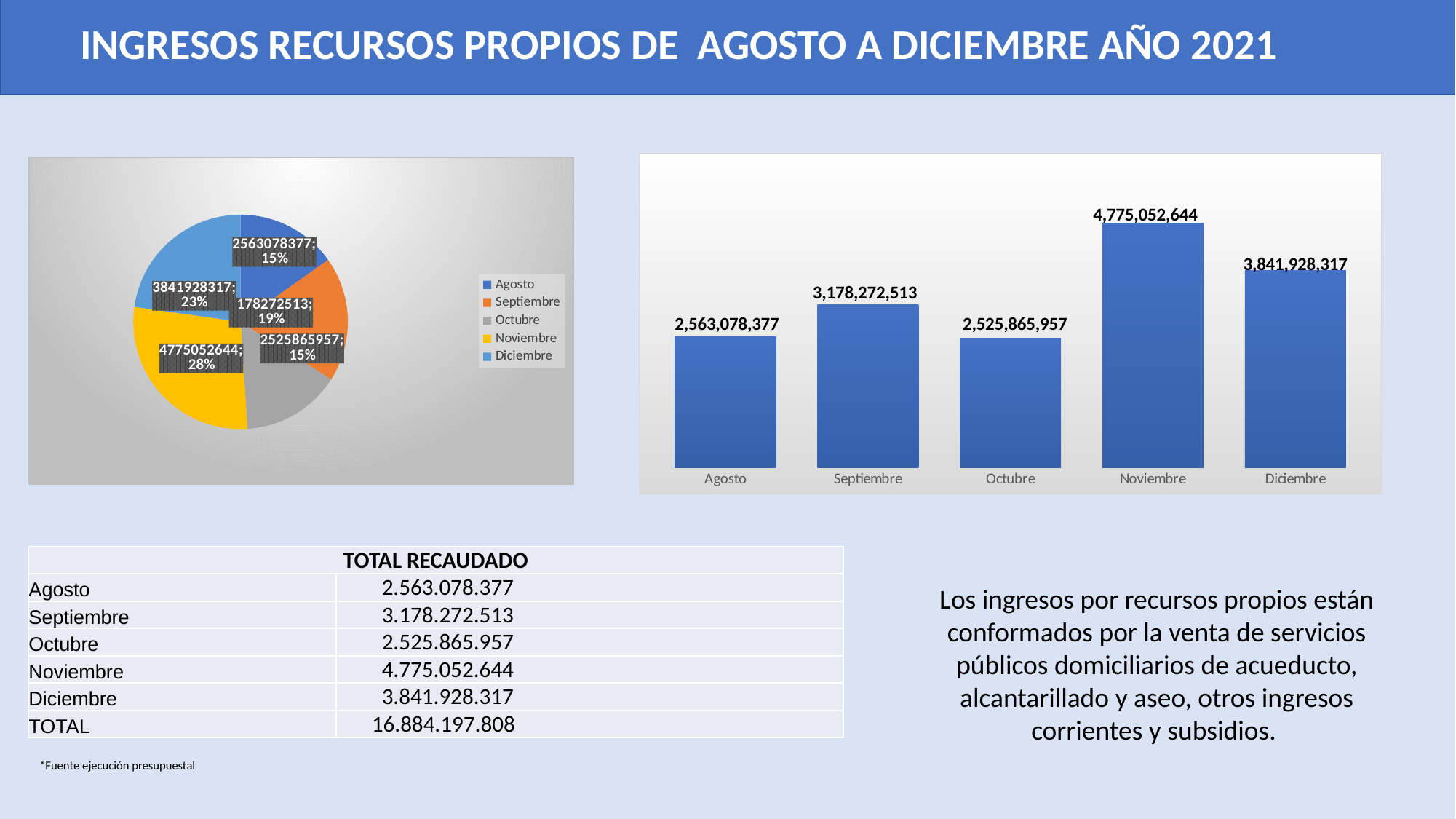
In the bar chart on the right, what is the value for Octubre? 2,525,865,957 In the pie chart on the left, what share does Noviembre have? 28% In the bar chart on the right, which month has the highest value? Noviembre In the bar chart on the right, which month has the lowest value? Octubre What kind of chart is the chart on the left of the slide? pie chart In the bar chart on the right, what is the value for Noviembre? 4,775,052,644 In the bar chart on the right, what is the value for Septiembre? 3,178,272,513 In the bar chart on the right, which is larger, the value for Septiembre or the value for Diciembre? Diciembre What kind of chart is the chart on the right of the slide? bar chart In the pie chart on the left, what share does Diciembre have? 23% In the bar chart on the right, what is the difference between the values for Noviembre and Diciembre? 933,124,327 How many months are shown in the bar chart on the right? 5